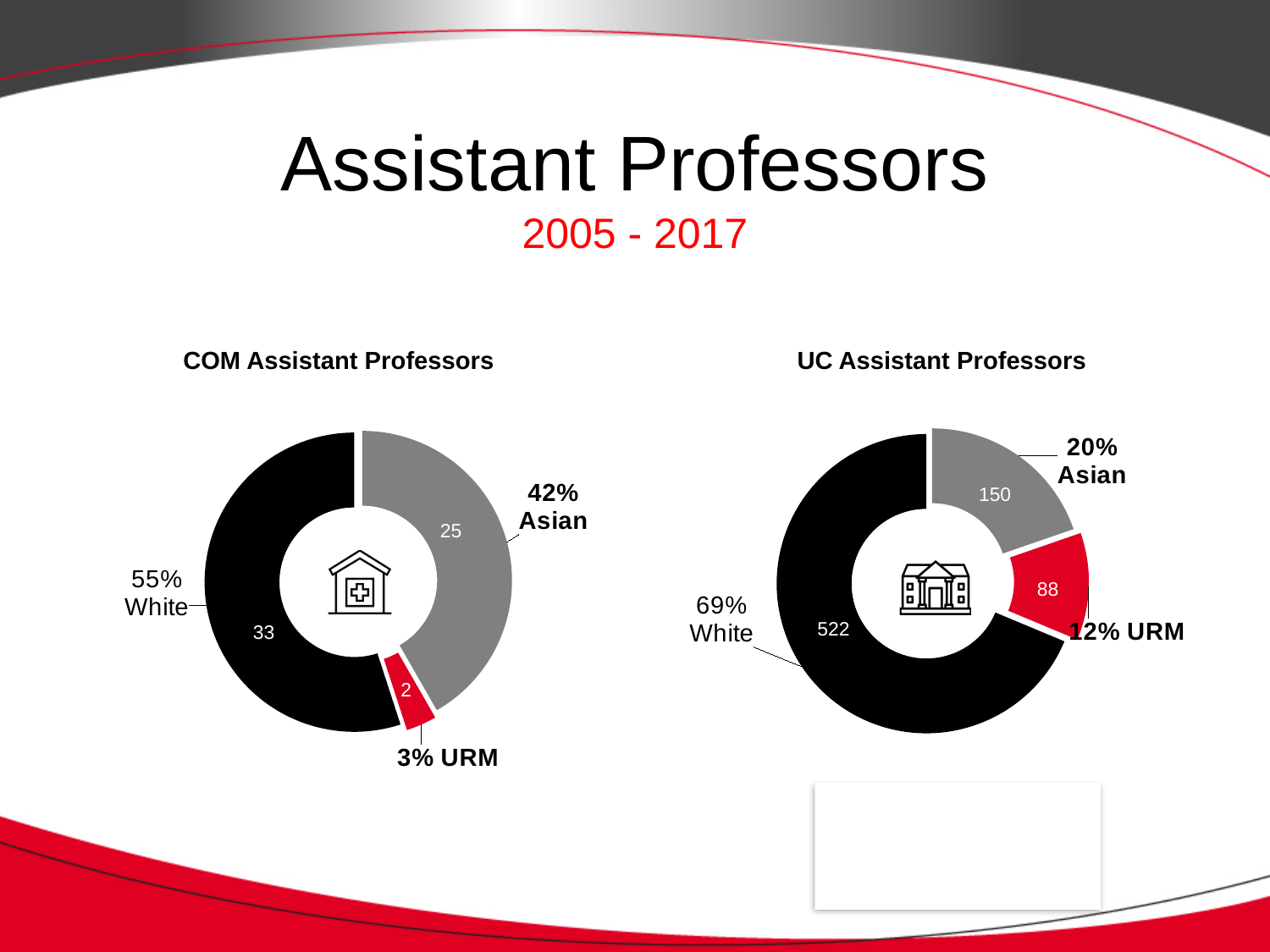
What kind of chart is the COM Assistant Professors chart? Doughnut chart In the COM Assistant Professors chart, what is the value for White? 33 In the COM Assistant Professors chart, what share of the total is Asian? 42% In the COM Assistant Professors chart, what is the value for Asian? 25 In the UC Assistant Professors chart, which category has the smallest value? URM In the COM Assistant Professors chart, what is the value for URM? 2 In the UC Assistant Professors chart, what is the value for URM? 88 In the UC Assistant Professors chart, what is the value for White? 522 In the UC Assistant Professors chart, what is the difference between the White and Asian values? 372 In the COM Assistant Professors chart, which category has the largest value? White In the UC Assistant Professors chart, what share of the total is URM? 12% In the UC Assistant Professors chart, what is the value for Asian? 150